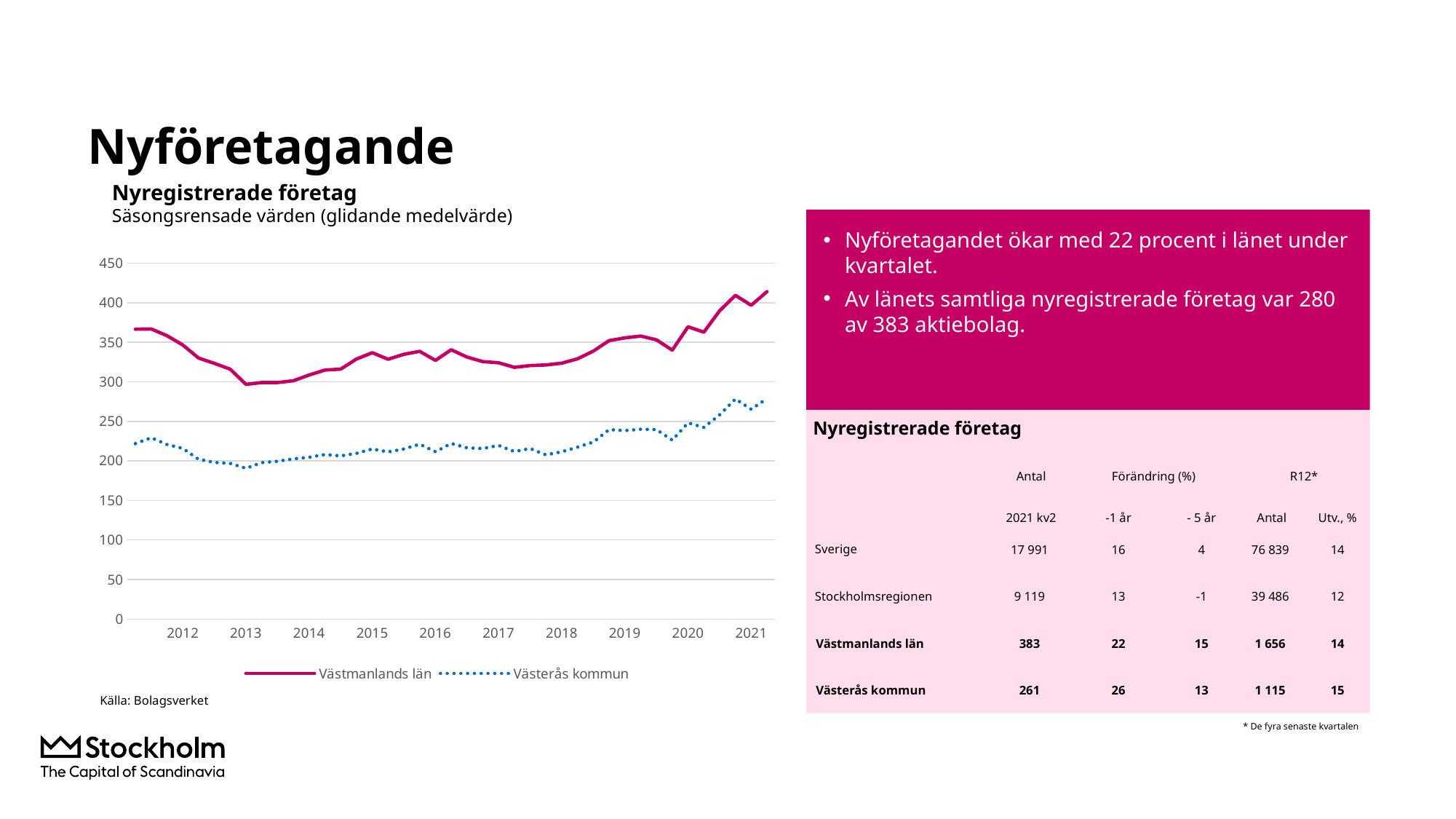
Is the value for Västerås kommun at the start of 2013 greater or less than 200? less What is the title of the chart? Nyregistrerade företag Does the Västerås kommun line rise or fall between 2019 and 2021? rise What kind of chart is shown on the slide? line chart Is the value for Västerås kommun at the end of 2021 greater or less than 250? greater Does the Västmanlands län line rise or fall between 2012 and 2013? fall How many series does the chart legend list? 2 Is the value for Västmanlands län at the end of 2021 greater or less than 400? greater Which series has the higher value in 2020, Västmanlands län or Västerås kommun? Västmanlands län Which two series are shown in the chart legend? Västmanlands län and Västerås kommun